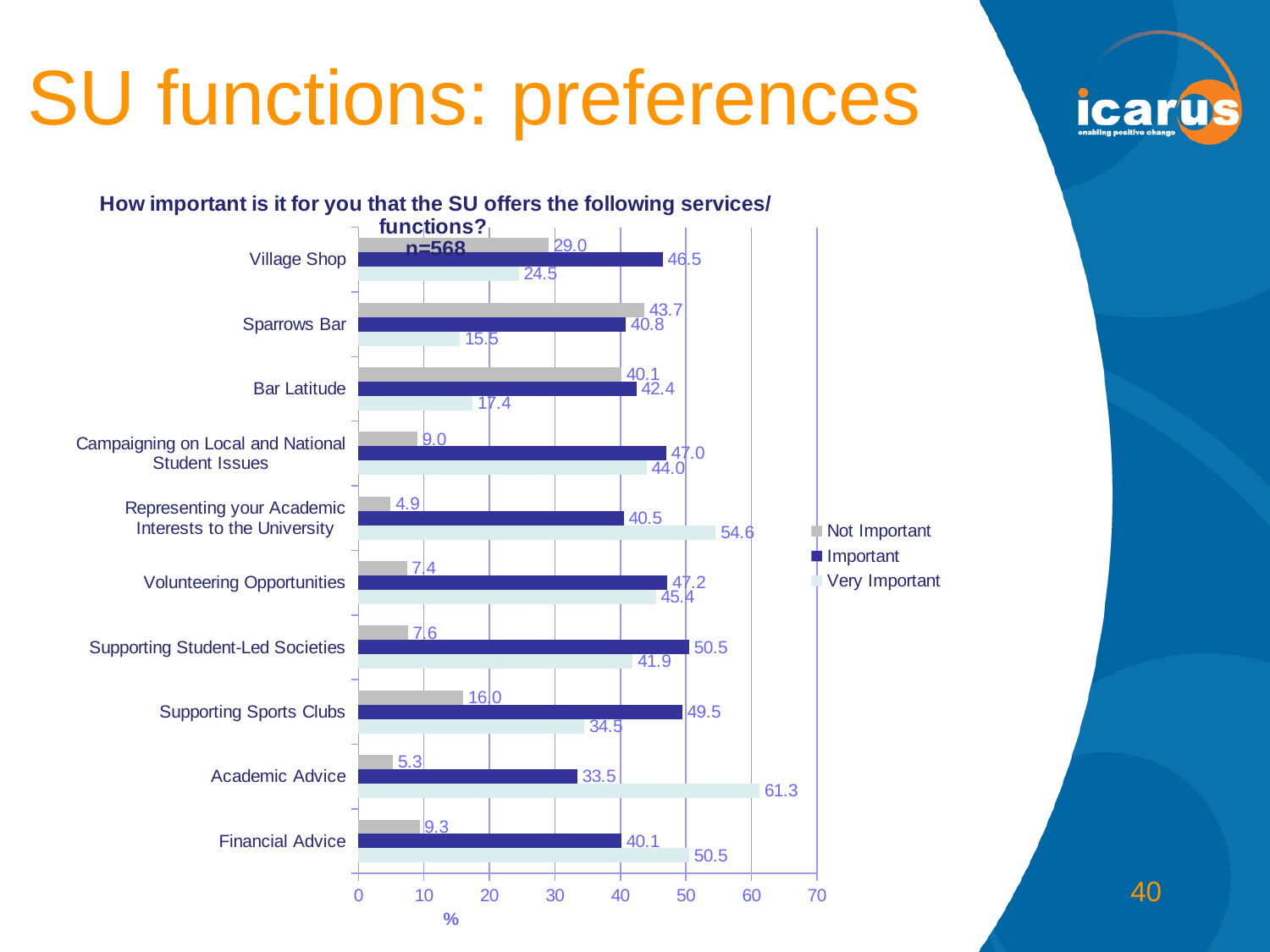
For Academic Advice, what is the difference between the Very Important and Important percentages? 27.8 What sample size (n) is stated on the chart? n=568 Is the Very Important value for Representing your Academic Interests to the University greater or less than 50? greater What is the Not Important value for Sparrows Bar? 43.7 What type of chart is shown on the slide? Bar chart What is the Important value for Supporting Student-Led Societies? 50.5 Which service has the highest Very Important percentage? Academic Advice How many series does the legend list? 3 What percentage of respondents rated Academic Advice as Very Important? 61.3 Which is larger for Village Shop: the Not Important value or the Very Important value? Not Important Which service has the lowest Not Important percentage? Representing your Academic Interests to the University How many services/functions are listed on the chart? 10